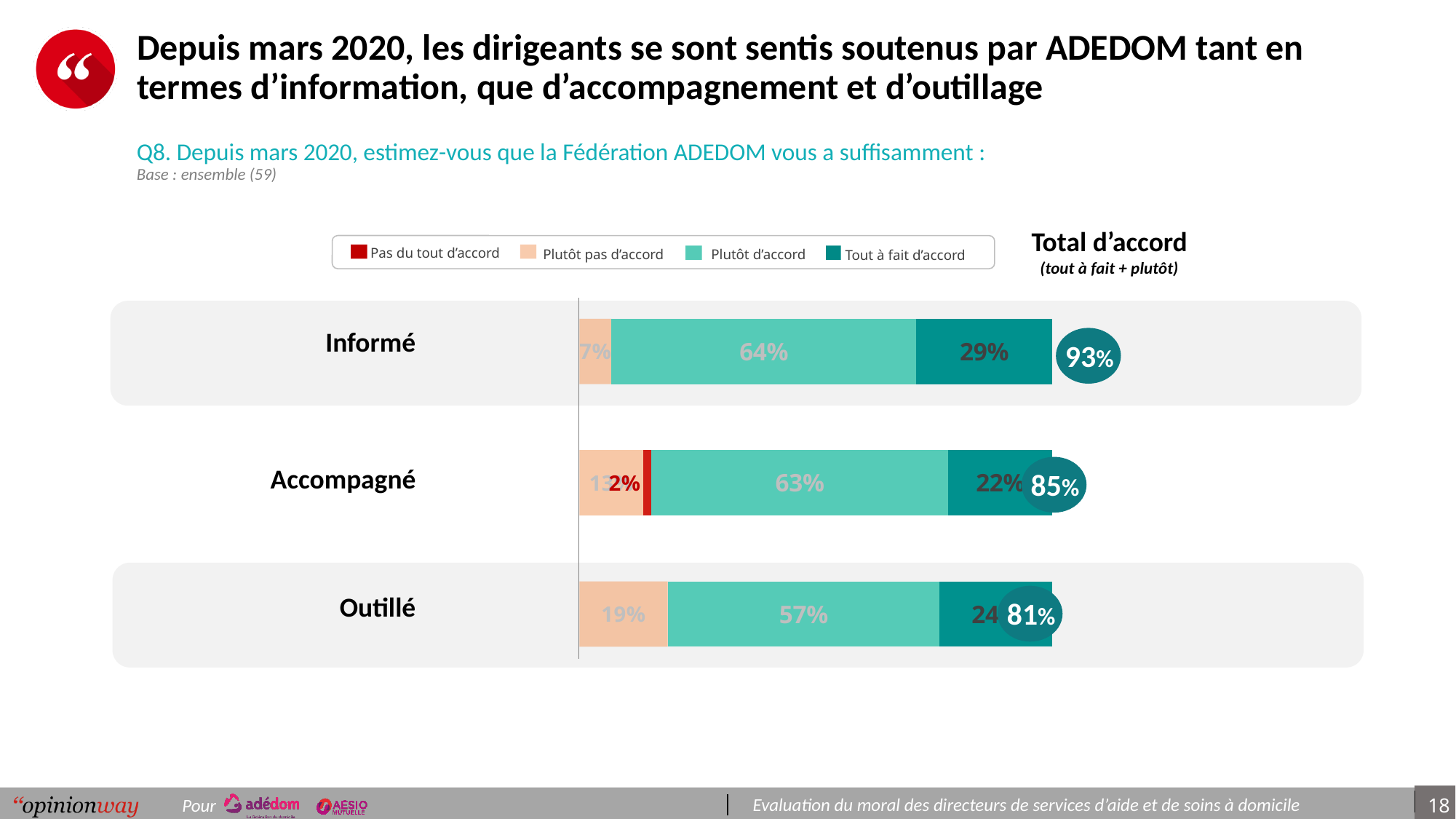
Which category has the lowest "Total d'accord" value? Outillé What percentage of respondents answered "Tout à fait d'accord" for Informé? 29% Which category has the highest "Total d'accord" value? Informé How many series does the legend list? 4 What percentage of respondents answered "Pas du tout d'accord" for Accompagné? 2% Which has a larger "Plutôt pas d'accord" share, Informé or Outillé? Outillé What percentage of respondents answered "Plutôt pas d'accord" for Outillé? 19% How many categories are shown in the chart? 3 What is the "Total d'accord" value for Informé? 93% What is the difference between the "Total d'accord" values for Informé and Outillé? 12 points What percentage of respondents answered "Plutôt d'accord" for Informé? 64% What is the "Total d'accord" value for Accompagné? 85%